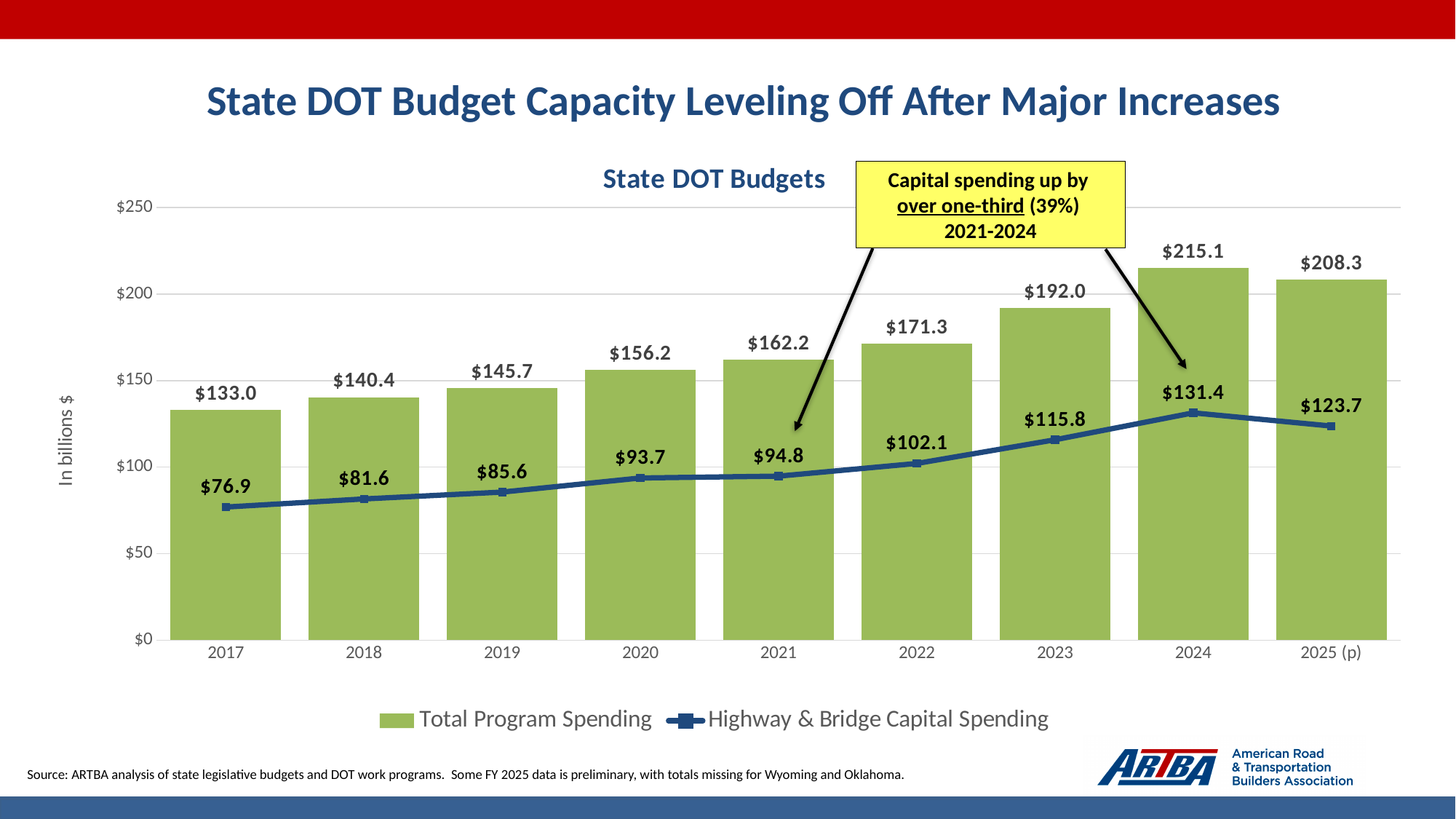
Does Total Program Spending rise or fall from 2017 to 2024? rise What kind of chart is used for Total Program Spending? bar chart What is the difference between Total Program Spending in 2024 and 2025 (p)? $6.8 Is the Total Program Spending value for 2019 greater or less than 150? less How many series does the legend list? 2 What is the Total Program Spending value for 2020? $156.2 What is the Highway & Bridge Capital Spending value for 2023? $115.8 How many years are shown on the x axis? 9 Which year has the lowest Highway & Bridge Capital Spending? 2017 What is the title of the chart? State DOT Budgets Which year has the highest Total Program Spending? 2024 Which is larger: Highway & Bridge Capital Spending in 2021 or in 2022? 2022